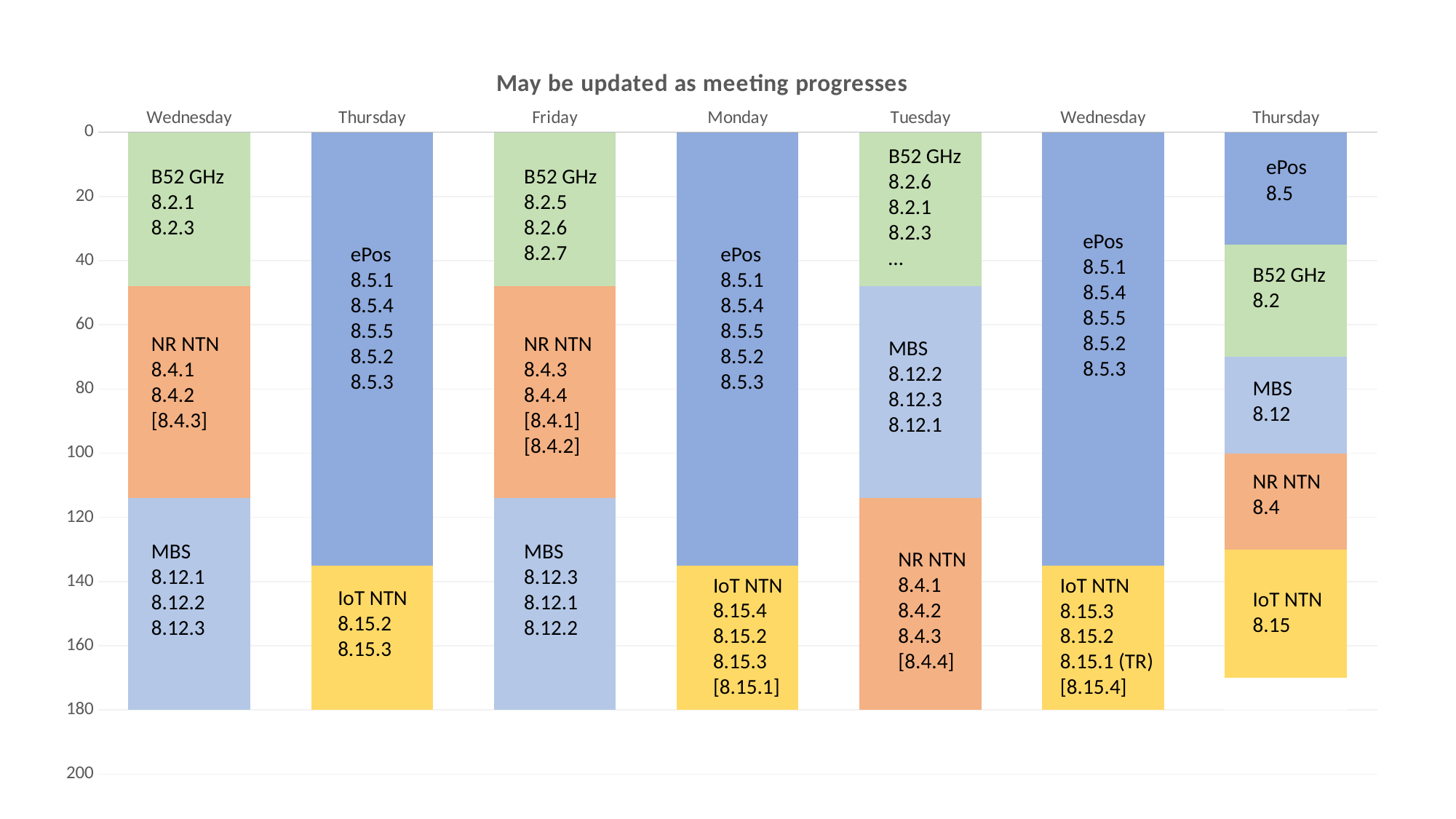
How many segments does the last Thursday bar contain? 5 Which agenda item is listed for ePos in the last Thursday bar? 8.5 Which segment is larger in the Monday bar, ePos or IoT NTN? ePos Which day's bar is the shortest? Thursday (last bar) What kind of chart is shown on the slide? bar chart Which topic occupies the top segment of the first Wednesday bar? B52 GHz Which topic occupies the bottom segment of the Monday bar? IoT NTN How many day bars are plotted on the chart? 7 Which topic sits between B52 GHz and NR NTN in the Tuesday bar? MBS Does the last Thursday bar end at a value greater or less than 180? less What is the title of the chart? May be updated as meeting progresses Which agenda items are listed under IoT NTN in the first Thursday bar? 8.15.2, 8.15.3